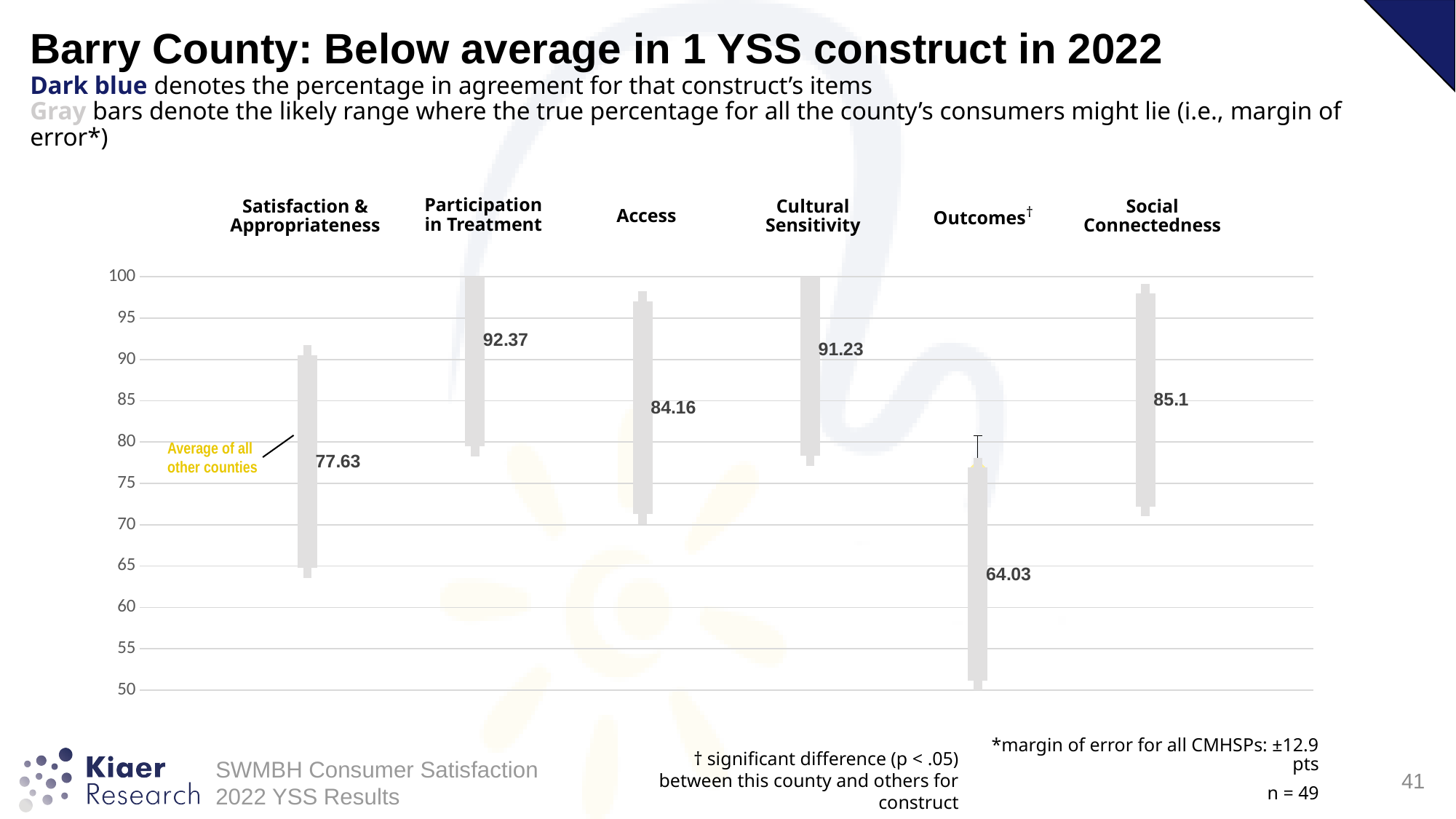
Which construct is marked with a dagger (†) indicating a significant difference from other counties? Outcomes How many constructs are shown on the chart? 6 Which construct has the lowest value? Outcomes What is the value shown for Satisfaction & Appropriateness? 77.63 Is the value for Cultural Sensitivity greater or less than 90? greater Which construct has the highest value? Participation in Treatment What is the difference between the values for Cultural Sensitivity and Access? 7.07 Which is larger, the value for Access or the value for Social Connectedness? Social Connectedness What is the value shown for Outcomes? 64.03 What is the value shown for Social Connectedness? 85.1 What is the difference between the values for Participation in Treatment and Outcomes? 28.34 What is the value shown for Participation in Treatment? 92.37